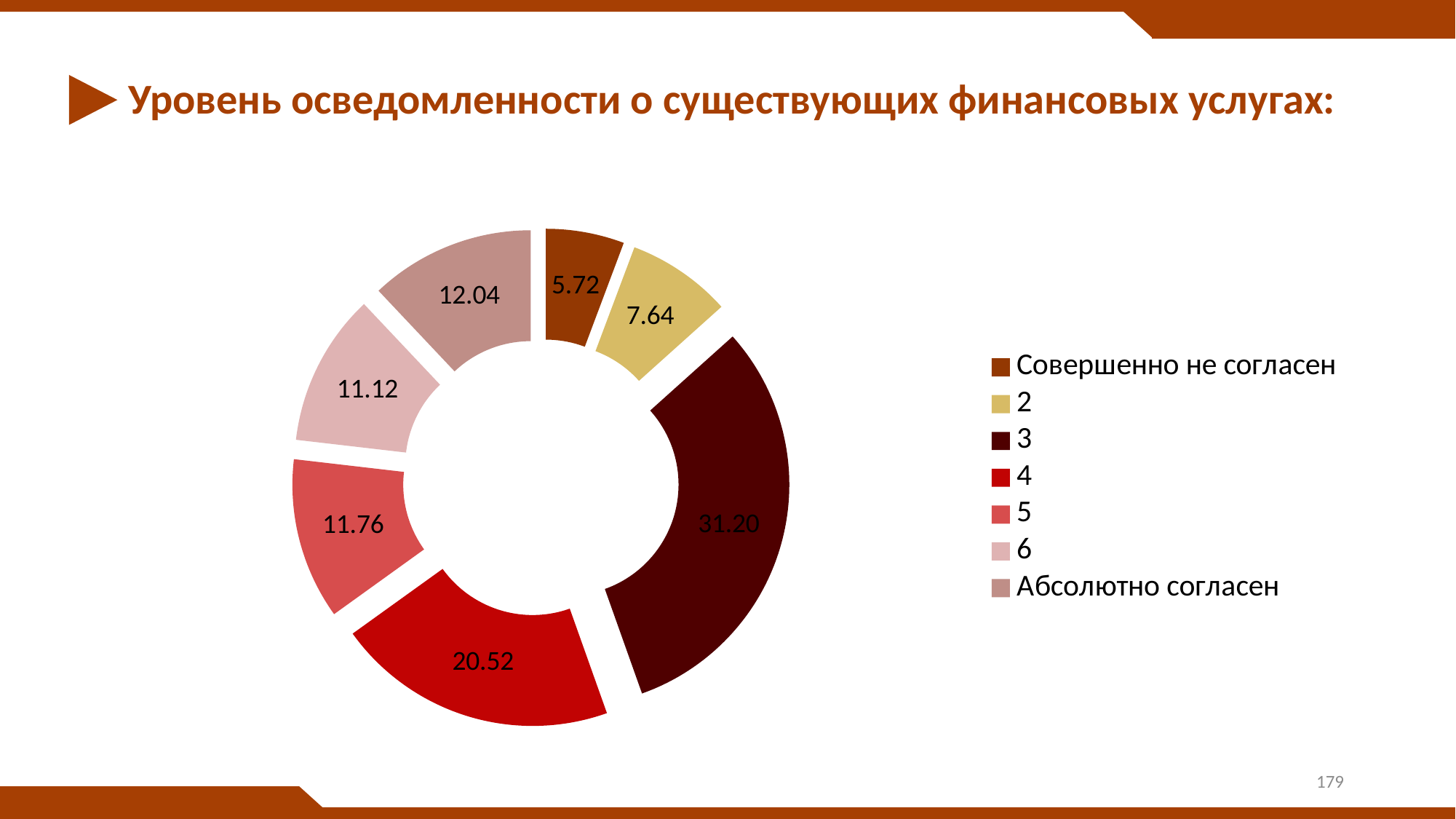
How many categories does the legend list? 7 Which category has the smallest segment? Совершенно не согласен What is the title of the slide? Уровень осведомленности о существующих финансовых услугах: Which is larger, the value for segment "2" or for "Совершенно не согласен"? 2 What kind of chart is shown on the slide? Doughnut chart What is the difference between the values for "Абсолютно согласен" and segment "6"? 0.92 What is the value for the segment "Совершенно не согласен"? 5.72 What is the value for segment "3"? 31.20 What is the value for segment "5"? 11.76 What is the value for the segment "Абсолютно согласен"? 12.04 Which category has the largest segment? 3 What is the difference between the values for segments "3" and "4"? 10.68